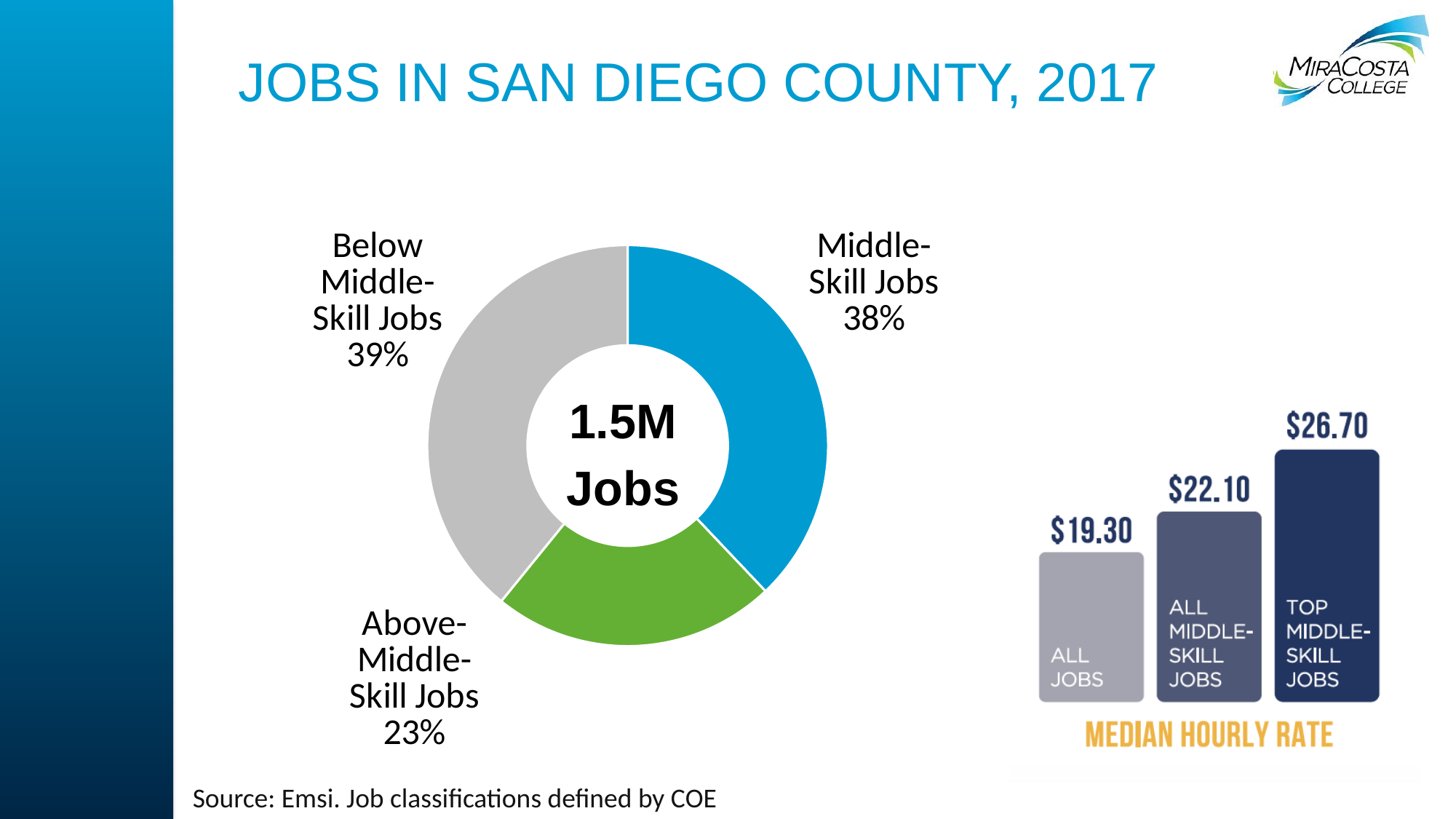
In the donut chart on the left, what total number of jobs is shown in the centre? 1.5M Jobs In the Median Hourly Rate chart on the right, which category has the highest median hourly rate? Top Middle-Skill Jobs In the Median Hourly Rate chart on the right, what is the difference between the median hourly rate for Top Middle-Skill Jobs and All Jobs? $7.40 What kind of chart is the Median Hourly Rate chart on the right? Bar chart In the donut chart on the left, how many categories are shown? 3 In the donut chart on the left, what is the difference in share between Below Middle-Skill Jobs and Above-Middle-Skill Jobs? 16% In the Median Hourly Rate chart on the right, what is the median hourly rate for All Jobs? $19.30 In the donut chart on the left, what share of jobs are Above-Middle-Skill Jobs? 23% In the Median Hourly Rate chart on the right, what is the median hourly rate for All Middle-Skill Jobs? $22.10 In the donut chart on the left, what share of jobs are Below Middle-Skill Jobs? 39% In the donut chart on the left, which category has the smallest share? Above-Middle-Skill Jobs In the donut chart on the left, what share of jobs are Middle-Skill Jobs? 38%